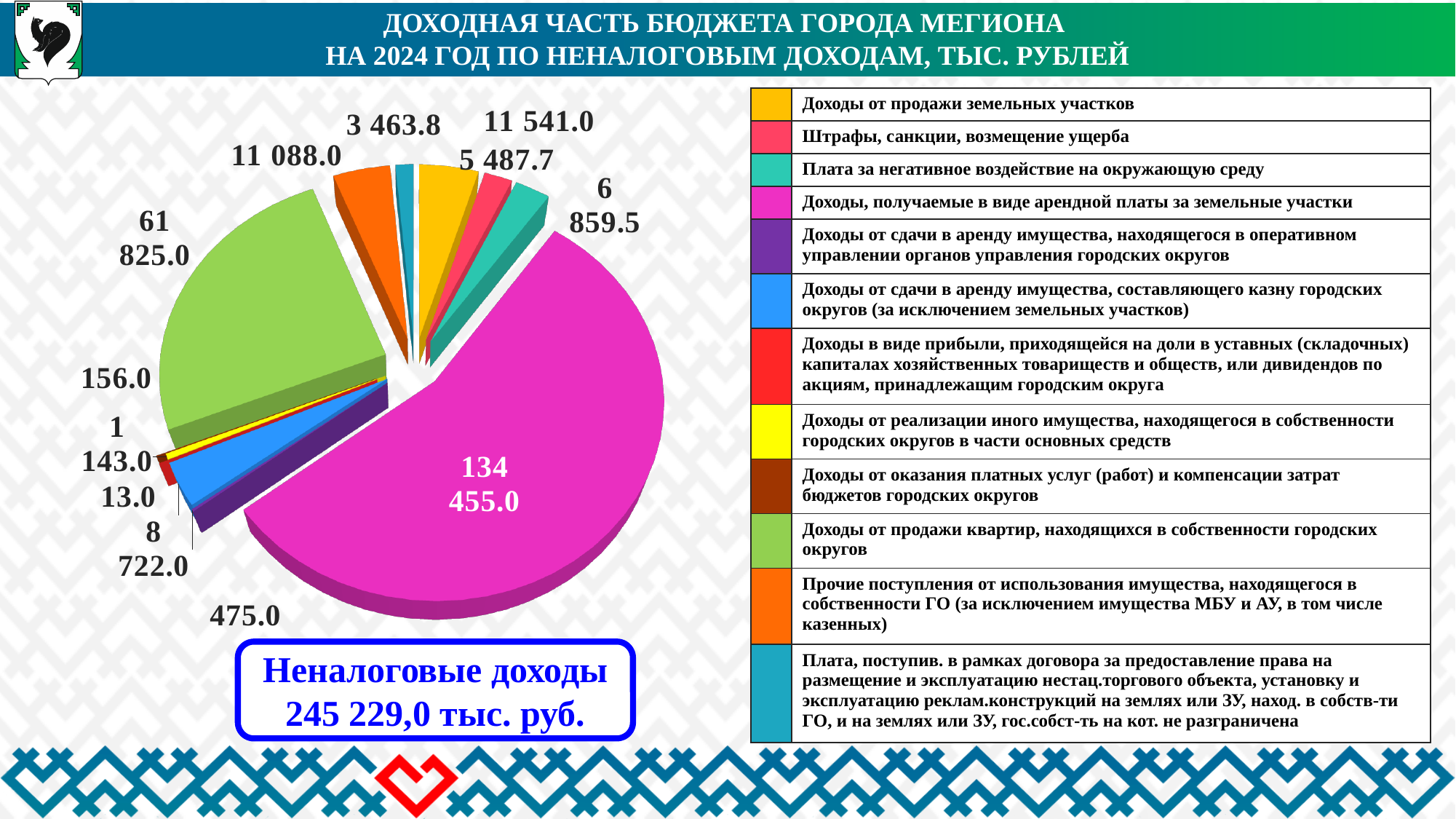
Which is larger: Доходы от продажи земельных участков or Прочие поступления от использования имущества, находящегося в собственности ГО? Доходы от продажи земельных участков What is the value of the largest slice, for Доходы, получаемые в виде арендной платы за земельные участки? 134 455.0 What is the title of the slide? Доходная часть бюджета города Мегиона на 2024 год по неналоговым доходам, тыс. рублей What is the value for Штрафы, санкции, возмещение ущерба? 5 487.7 What kind of chart is shown on the slide? Pie chart What is the value for Плата за негативное воздействие на окружающую среду? 6 859.5 What is the value for Доходы от продажи земельных участков? 11 541.0 What total of non-tax revenues (Неналоговые доходы) is stated on the slide? 245 229,0 тыс. руб. Which category has the largest slice of the pie? Доходы, получаемые в виде арендной платы за земельные участки What is the difference between the value for Доходы, получаемые в виде арендной платы за земельные участки (134 455.0) and Доходы от продажи квартир (61 825.0)? 72 630.0 How many categories does the legend list? 12 What is the value for Доходы от продажи квартир, находящихся в собственности городских округов? 61 825.0